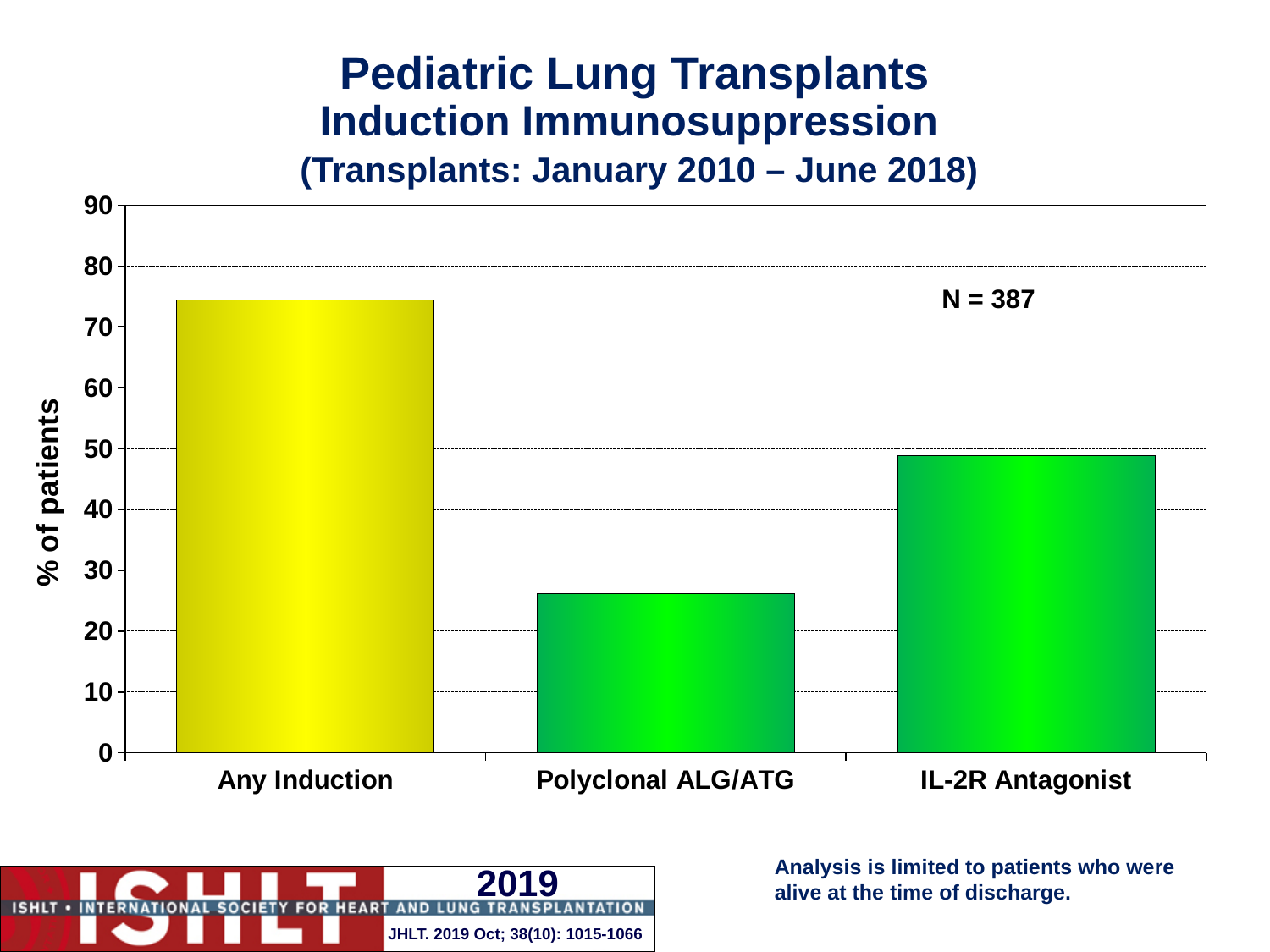
Which is larger, the value for IL-2R Antagonist or the value for Polyclonal ALG/ATG? IL-2R Antagonist What kind of chart is shown on the slide? bar chart Which is larger, the value for Any Induction or the value for IL-2R Antagonist? Any Induction How many categories are plotted on the x axis? 3 Which category has the lowest percentage of patients? Polyclonal ALG/ATG Is the value for IL-2R Antagonist greater or less than 40? greater Which category has the highest percentage of patients? Any Induction Is the value for Any Induction greater or less than 70? greater What is the N value shown on the chart? N = 387 Is the value for Any Induction greater or less than 80? less What is the label of the y axis? % of patients